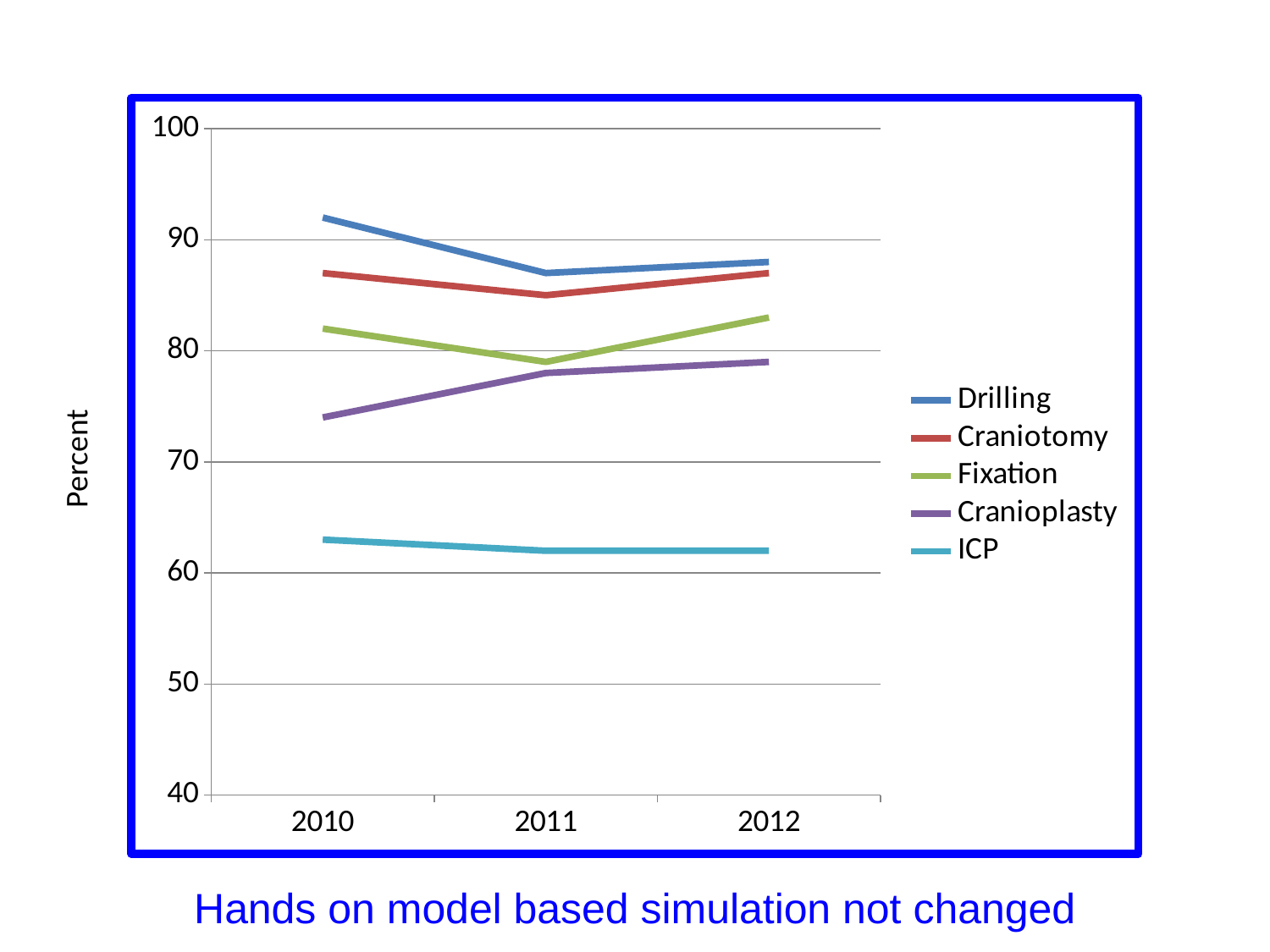
Which series has the lowest value in 2012? ICP Does the Cranioplasty line rise or fall from 2010 to 2012? rise Is the value for Drilling in 2010 greater or less than 90? greater What kind of chart is shown on the slide? line chart Which series has the highest value in 2010? Drilling In 2010, which is higher, Fixation or Cranioplasty? Fixation Is the value for Craniotomy in 2011 greater or less than 90? less How many years are plotted along the x axis? 3 Is the value for Cranioplasty in 2010 greater or less than 80? less What is the label on the y axis? Percent How many series does the legend list? 5